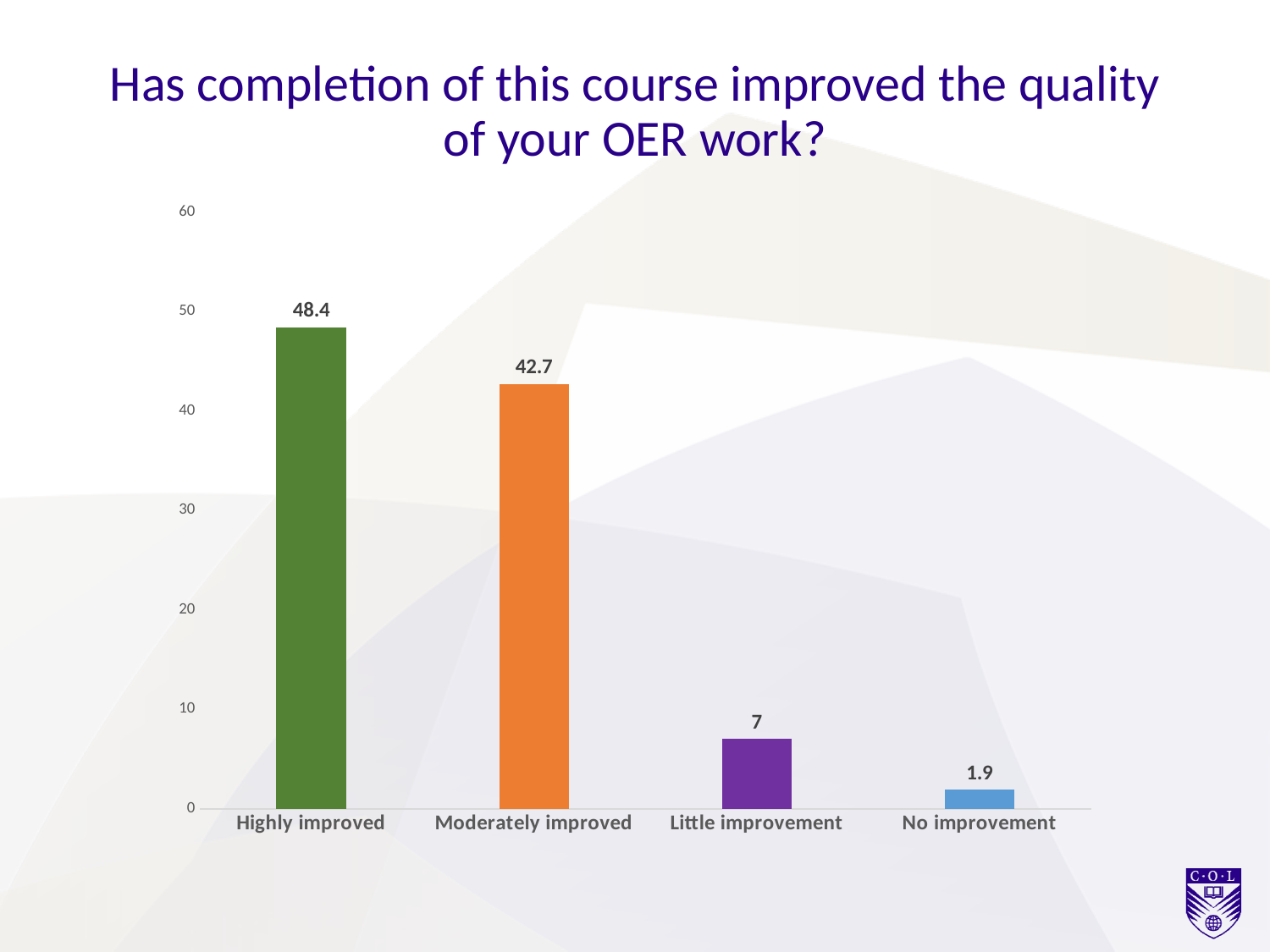
What is the difference between the values for Highly improved and Moderately improved? 5.7 What is the value for Highly improved? 48.4 What kind of chart is shown on the slide? bar chart What is the value for Moderately improved? 42.7 What is the value for Little improvement? 7 Which category has the lowest value? No improvement What is the difference between the values for Little improvement and No improvement? 5.1 What is the value for No improvement? 1.9 How many categories are shown on the x axis? 4 Which category has the highest value? Highly improved Is the value for Moderately improved greater or less than 40? greater Which is larger, the value for Moderately improved or the value for Little improvement? Moderately improved